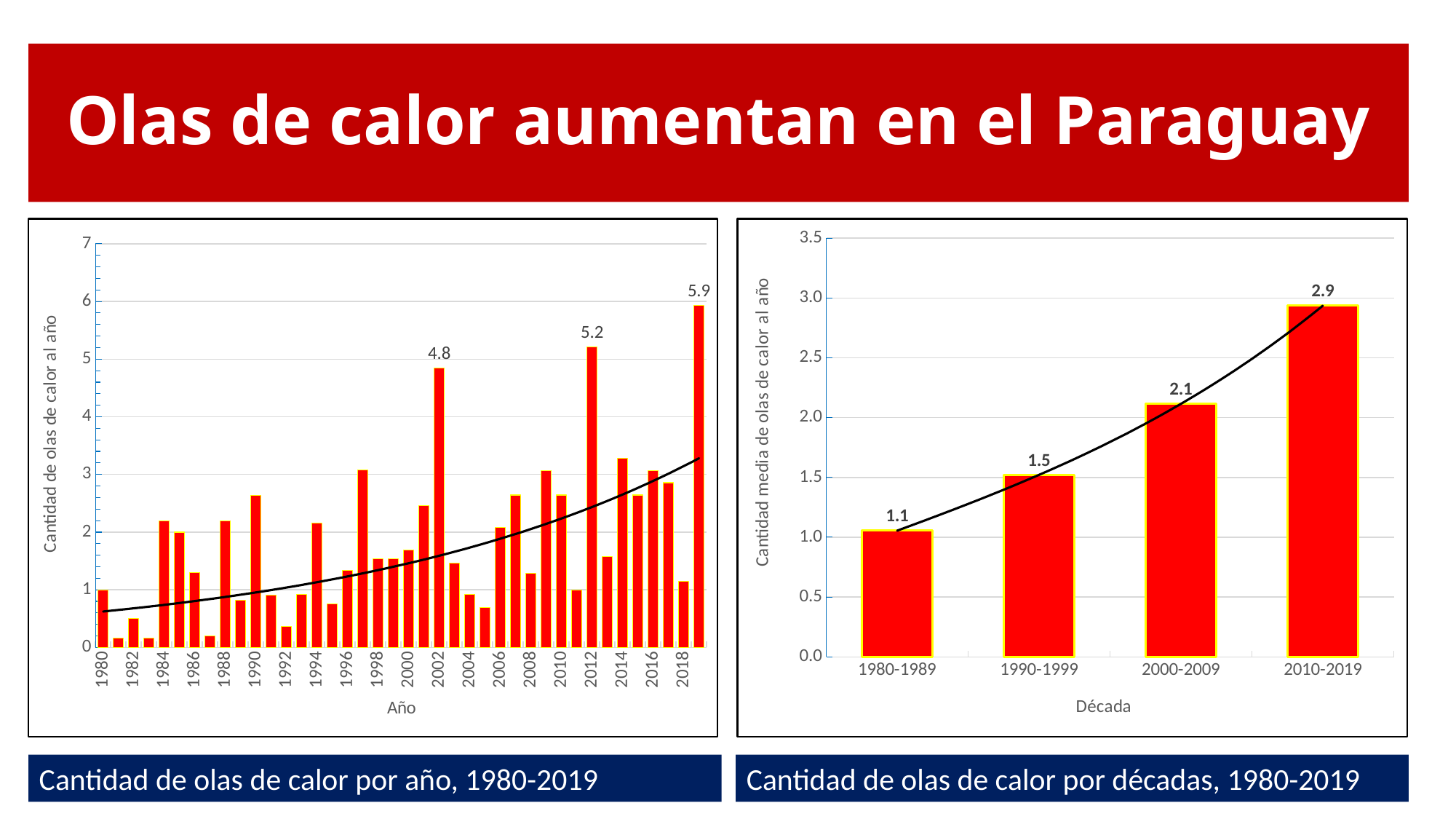
In the chart 'Cantidad de olas de calor por año, 1980-2019', what is the value for 2002? 4.8 In the chart 'Cantidad de olas de calor por décadas, 1980-2019', what is the value for 1980-1989? 1.1 In the chart 'Cantidad de olas de calor por décadas, 1980-2019', which decade has the lowest value? 1980-1989 In the chart 'Cantidad de olas de calor por año, 1980-2019', is the value for 1990 greater or less than 2? greater In the chart 'Cantidad de olas de calor por décadas, 1980-2019', how many decades are shown? 4 What kind of chart is 'Cantidad de olas de calor por año, 1980-2019'? bar chart In the chart 'Cantidad de olas de calor por décadas, 1980-2019', do the values rise or fall from 1980-1989 to 2010-2019? rise In the chart 'Cantidad de olas de calor por décadas, 1980-2019', which decade has the highest value? 2010-2019 In the chart 'Cantidad de olas de calor por año, 1980-2019', what is the value for 2012? 5.2 In the chart 'Cantidad de olas de calor por año, 1980-2019', which year has the larger value, 2002 or 2012? 2012 In the chart 'Cantidad de olas de calor por décadas, 1980-2019', what is the difference between the values for 2010-2019 and 1980-1989? 1.8 In the chart 'Cantidad de olas de calor por décadas, 1980-2019', what is the value for 2010-2019? 2.9